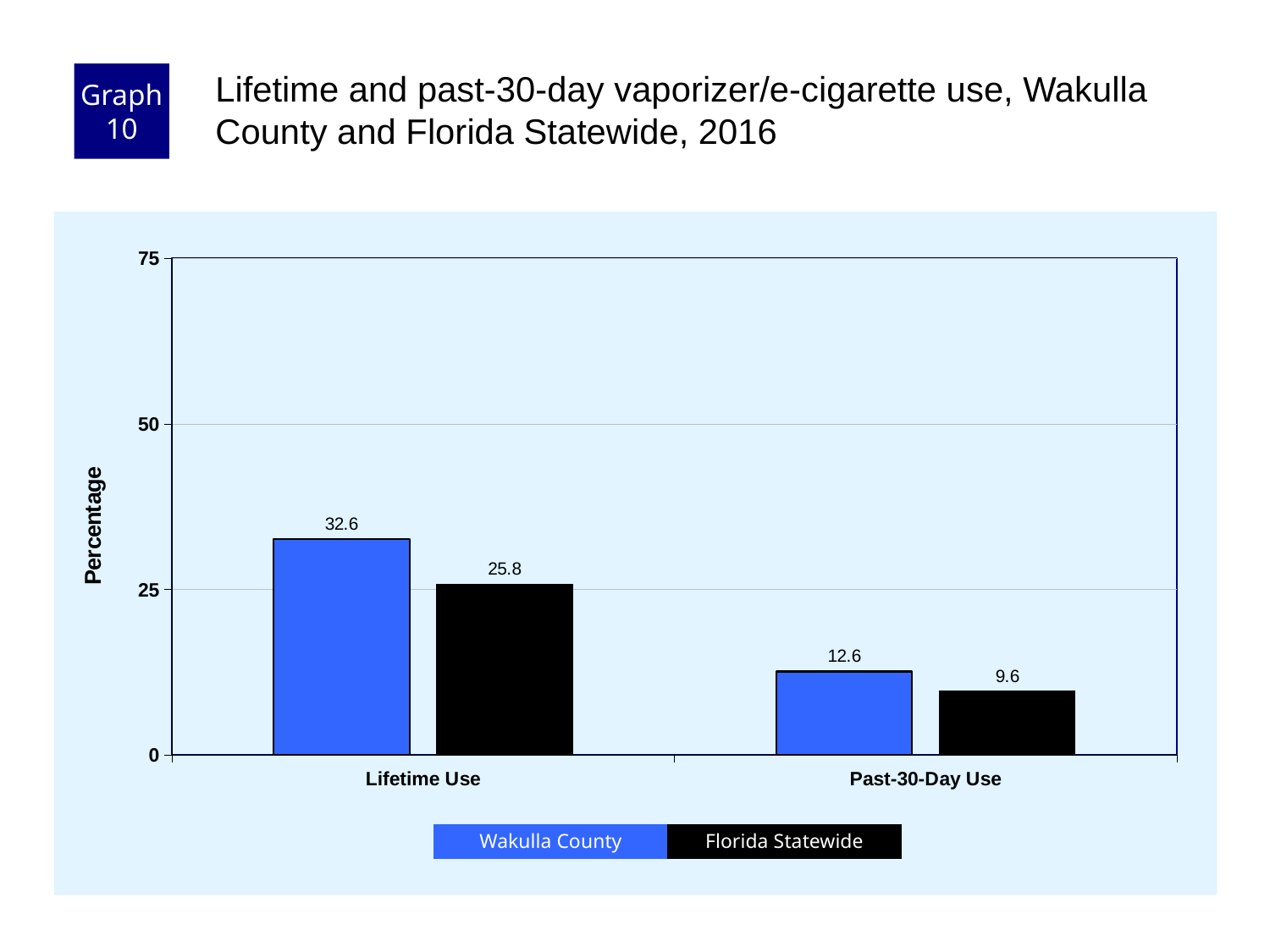
What is the value for Florida Statewide for Past-30-Day Use? 9.6 What is the value for Florida Statewide for Lifetime Use? 25.8 How many series does the legend list? 2 Which bar has the highest value on the chart? Wakulla County, Lifetime Use Which bar has the lowest value on the chart? Florida Statewide, Past-30-Day Use What is the difference between Wakulla County and Florida Statewide for Lifetime Use? 6.8 What is the value for Wakulla County for Lifetime Use? 32.6 What kind of chart is shown on the slide? Bar chart Which is larger for Past-30-Day Use, Wakulla County or Florida Statewide? Wakulla County What is the value for Wakulla County for Past-30-Day Use? 12.6 How many categories are shown on the x axis? 2 What is the difference between Wakulla County and Florida Statewide for Past-30-Day Use? 3.0